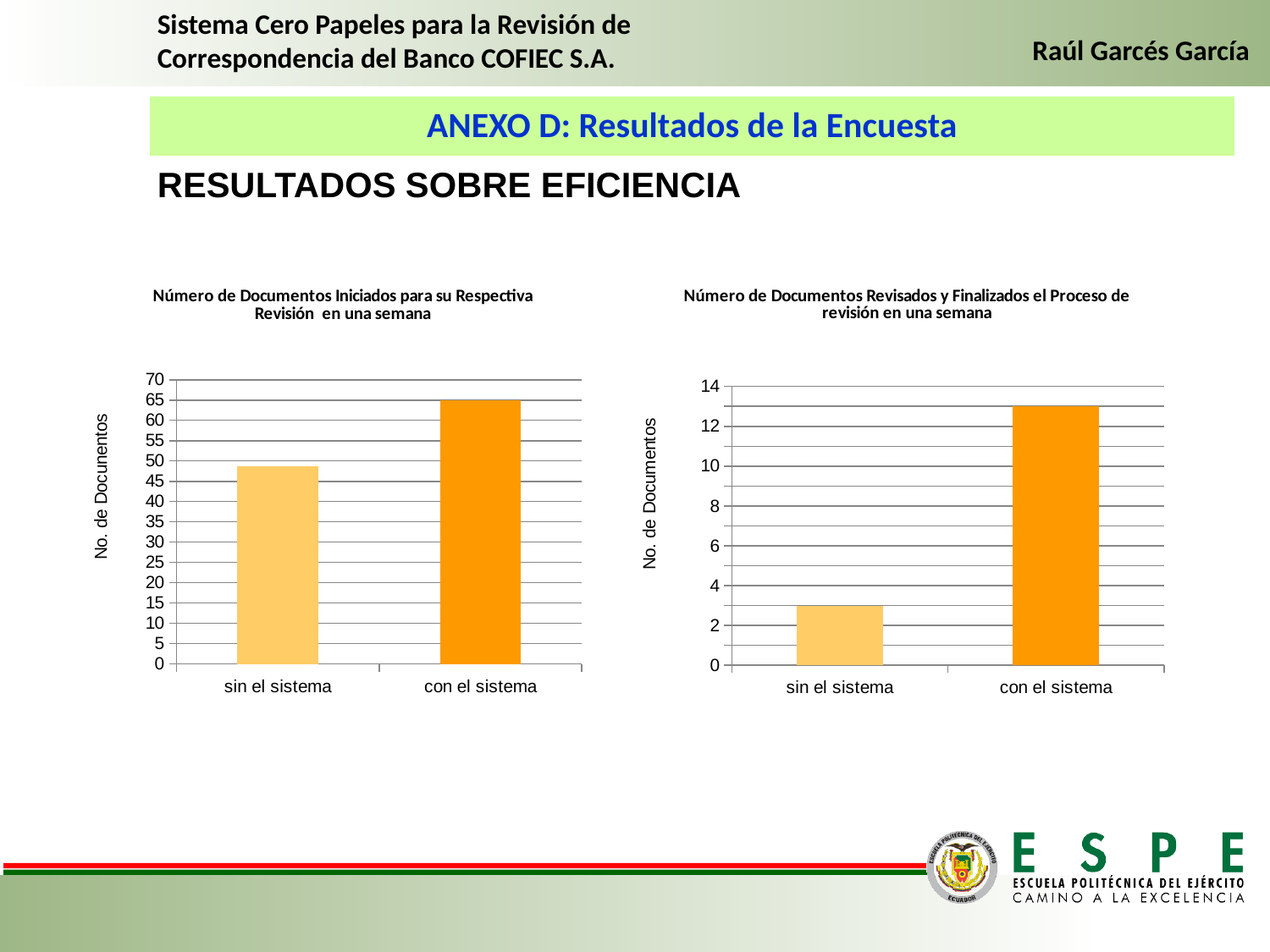
In the left chart (Número de Documentos Iniciados para su Respectiva Revisión en una semana), what is the value for 'con el sistema'? 65 In the left chart (Número de Documentos Iniciados), is the value for 'sin el sistema' greater or less than 40? greater How many categories are shown in the left chart (Número de Documentos Iniciados)? 2 In the left chart (Número de Documentos Iniciados), which category has the highest value? con el sistema What is the y-axis label of the left chart (Número de Documentos Iniciados)? No. de Docunentos In the left chart (Número de Documentos Iniciados), which category has the lowest value? sin el sistema What kind of chart is the right chart (Número de Documentos Revisados y Finalizados)? bar chart In the right chart (Número de Documentos Revisados y Finalizados), is the value for 'sin el sistema' greater or less than 4? less In the right chart (Número de Documentos Revisados y Finalizados), which category has the highest value? con el sistema In the right chart (Número de Documentos Revisados y Finalizados), which is larger, 'sin el sistema' or 'con el sistema'? con el sistema In the right chart (Número de Documentos Revisados y Finalizados), is the value for 'con el sistema' greater or less than 12? greater What is the title of the right chart on the slide? Número de Documentos Revisados y Finalizados el Proceso de revisión en una semana